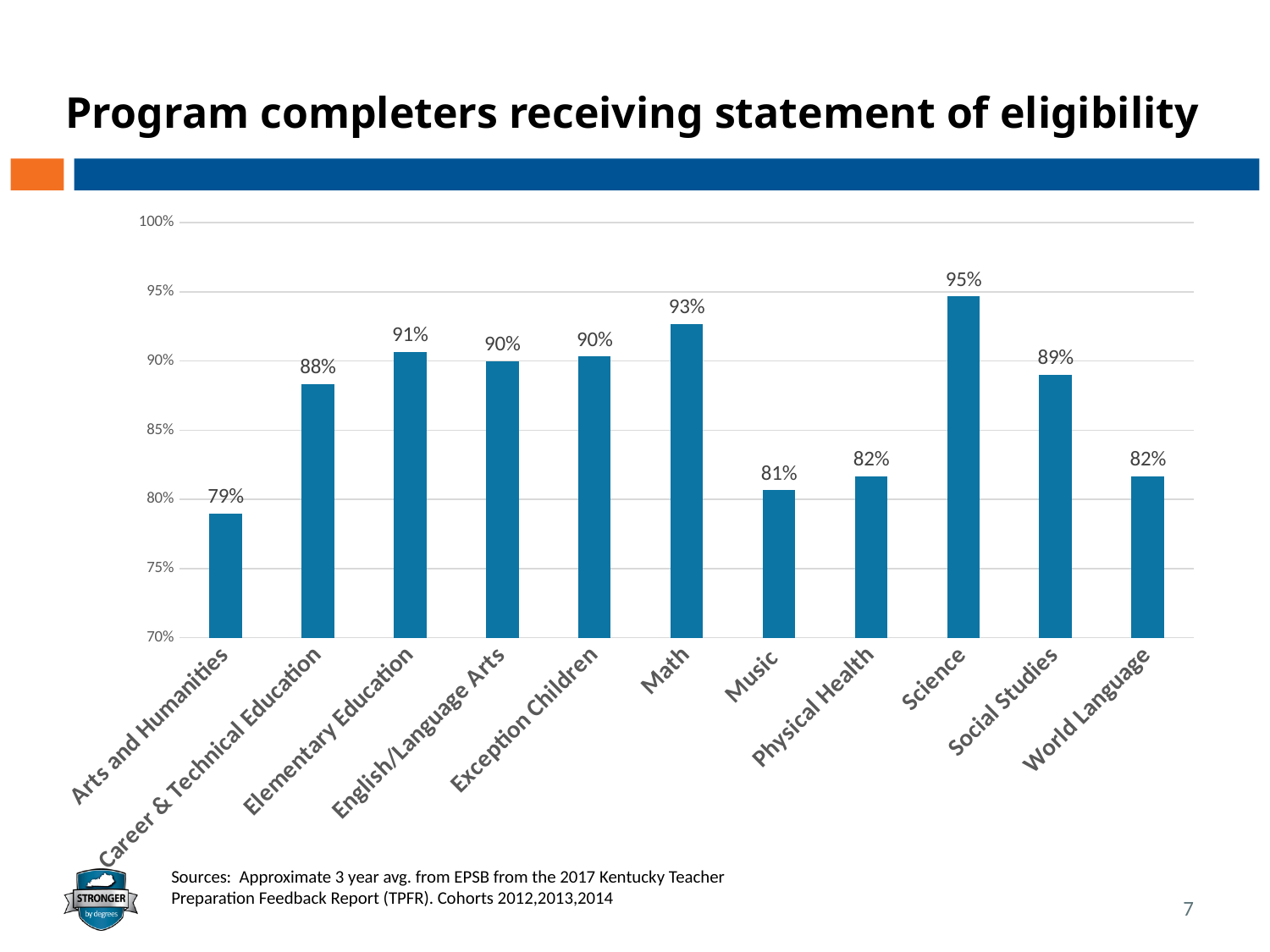
Is the value for Physical Health greater or less than 85%? less Which is larger, the value for Elementary Education or the value for Social Studies? Elementary Education What is the difference between the values for Math and Music? 12% How many categories are shown on the x axis? 11 Which category has the lowest percentage? Arts and Humanities What is the title of the chart? Program completers receiving statement of eligibility What is the value shown for Arts and Humanities? 79% What kind of chart is shown on the slide? Bar chart What is the value shown for Career & Technical Education? 88% What is the difference between the values for Science and Arts and Humanities? 16% Which category has the highest percentage of program completers receiving a statement of eligibility? Science What percentage of program completers in Science received a statement of eligibility? 95%